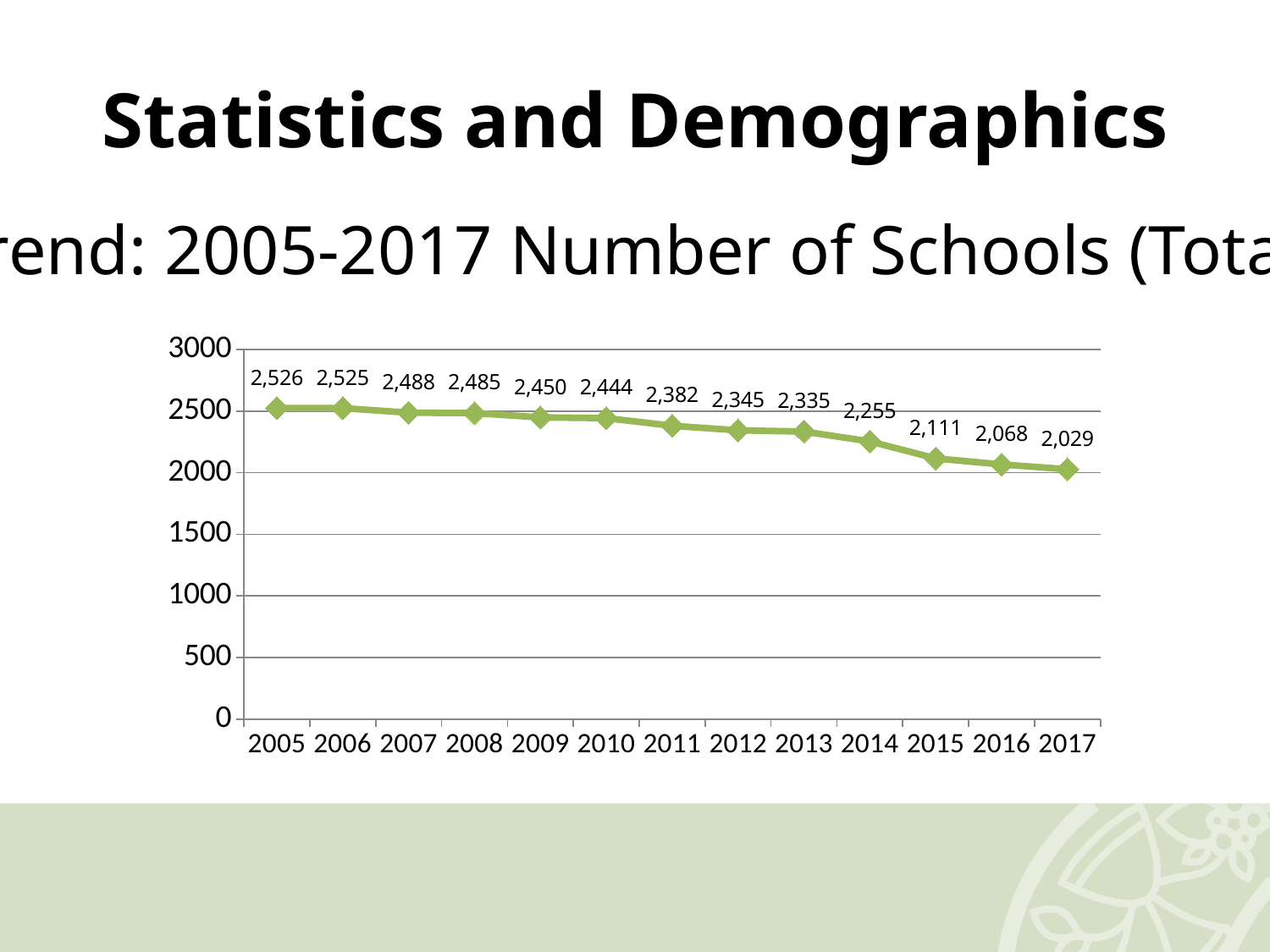
Which year has more schools, 2010 or 2013? 2010 What is the difference between the number of schools in 2014 and 2015? 144 How many years are plotted on the chart? 13 What is the number of schools in 2017? 2,029 Is the number of schools in 2016 greater or less than 2500? less What kind of chart is shown on the slide? line chart What is the difference between the number of schools in 2005 and 2017? 497 What is the number of schools in 2005? 2,526 Does the number of schools rise or fall from 2005 to 2017? fall Which year has the lowest number of schools? 2017 Which year has the highest number of schools? 2005 What is the number of schools in 2014? 2,255